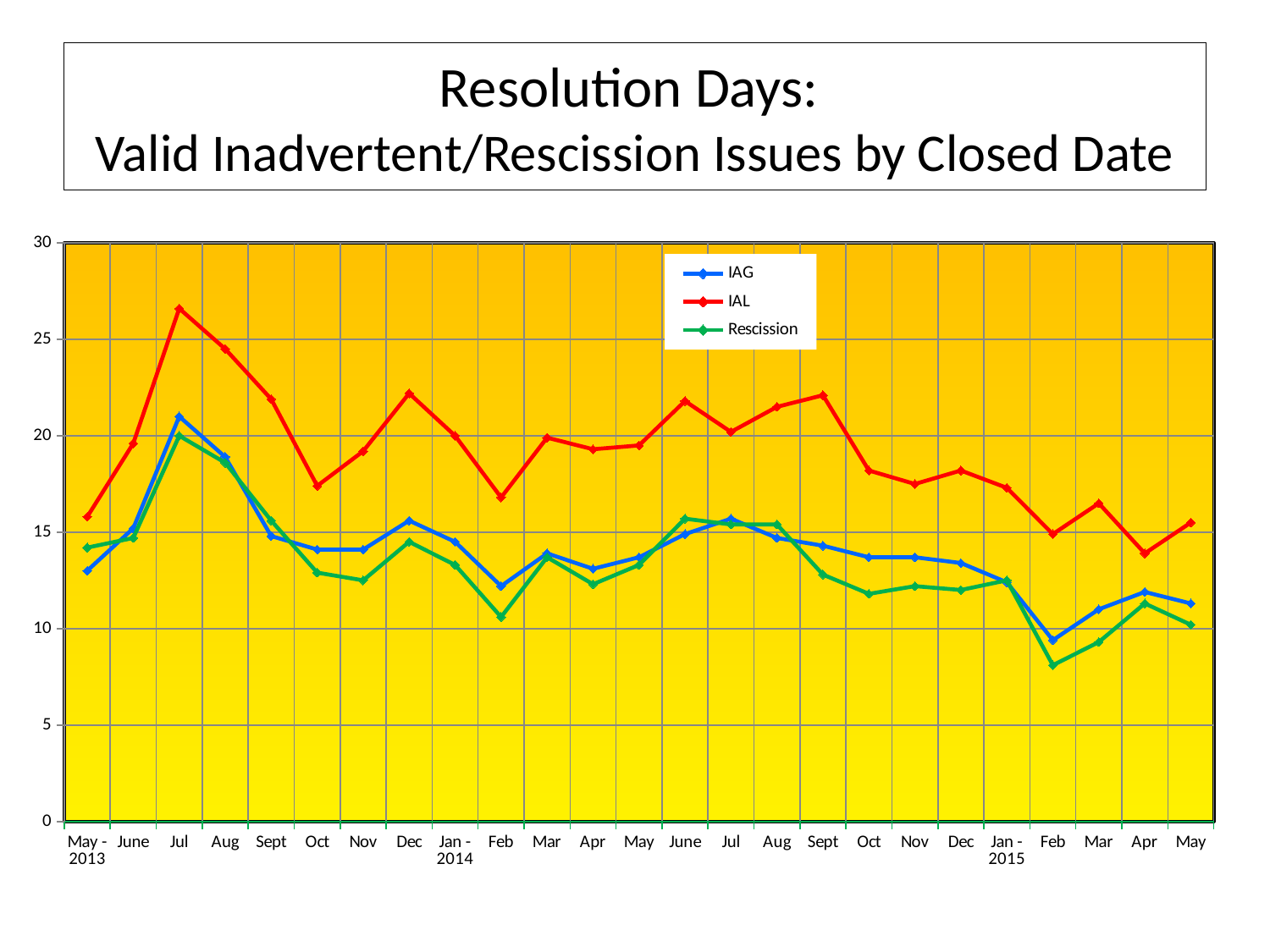
Is the IAG value for Jul 2013 greater or less than 20? greater In which month is the IAG series at its highest? Jul (2013) Is the IAL value for Jul 2013 greater or less than 25? greater Is the IAL value for Oct 2013 greater or less than 20? less In which month is the Rescission series at its lowest? Feb (2015) In which month is the IAL series at its highest? Jul (2013) How many points are plotted along the x axis for each series? 25 Which series is larger in Jul 2013, IAL or IAG? IAL Does the IAL series rise or fall from Jul 2013 to Oct 2013? fall How many series does the legend list? 3 What kind of chart is shown on the slide? line chart